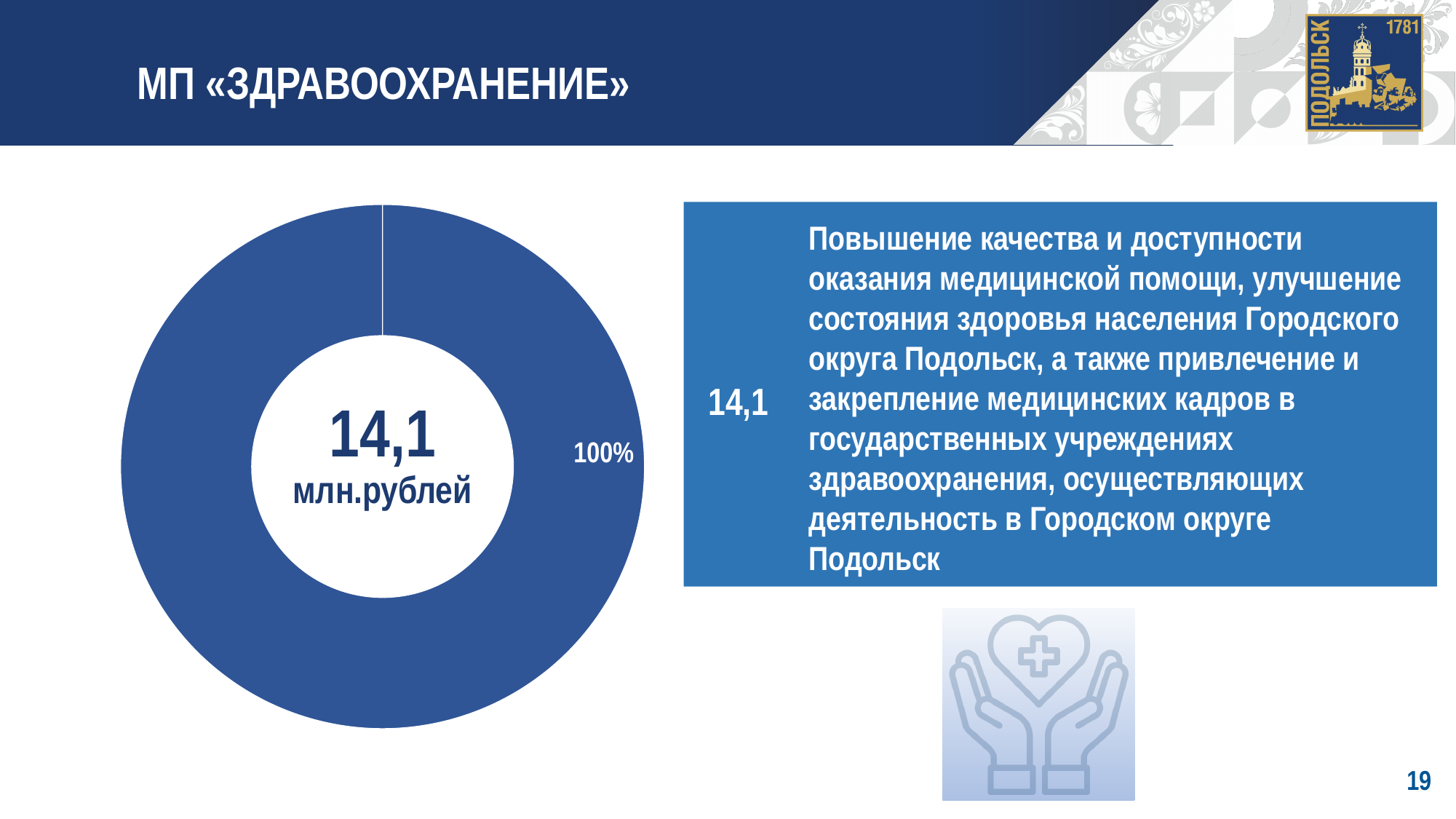
What kind of chart is shown on the slide? doughnut chart What percentage is printed next to the single slice of the pie chart? 100% What is the title of the slide containing the pie chart? МП «ЗДРАВООХРАНЕНИЕ» What value is printed in the blue box to the right of the chart, next to the programme description? 14,1 What unit is printed under the value in the centre of the pie chart? млн.рублей What colour is the slice of the pie chart? blue What is the total amount in million rubles shown in the centre of the pie chart? 14,1 What value is printed in the centre of the pie chart? 14,1 млн.рублей What share of the pie chart does the single slice occupy? 100% How many slices does the pie chart have? 1